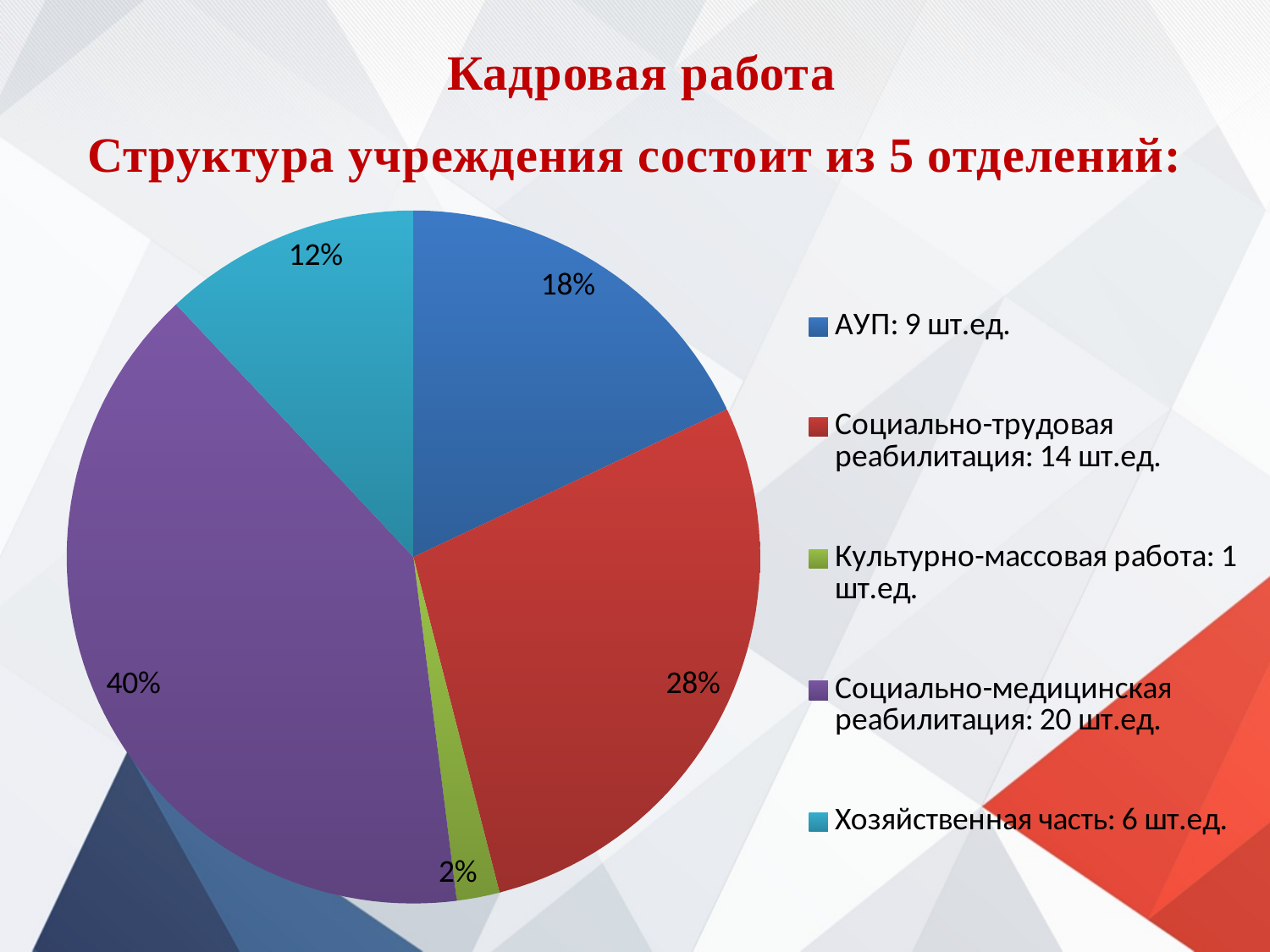
What is the difference in percentage points between the Социально-трудовая реабилитация slice and the АУП slice? 10 Which category has the largest slice of the pie? Социально-медицинская реабилитация What kind of chart is shown on the slide? pie chart Which slice is larger: Социально-трудовая реабилитация or Хозяйственная часть? Социально-трудовая реабилитация What colour is the slice for Хозяйственная часть? light blue (cyan) What percentage share does the slice for Культурно-массовая работа have? 2% How many staff units (шт.ед.) does the legend list for Социально-трудовая реабилитация? 14 шт.ед. What percentage share does the slice for Хозяйственная часть have? 12% How many slices does the pie chart have? 5 Which category has the smallest slice of the pie? Культурно-массовая работа What percentage share does the slice for АУП have? 18%